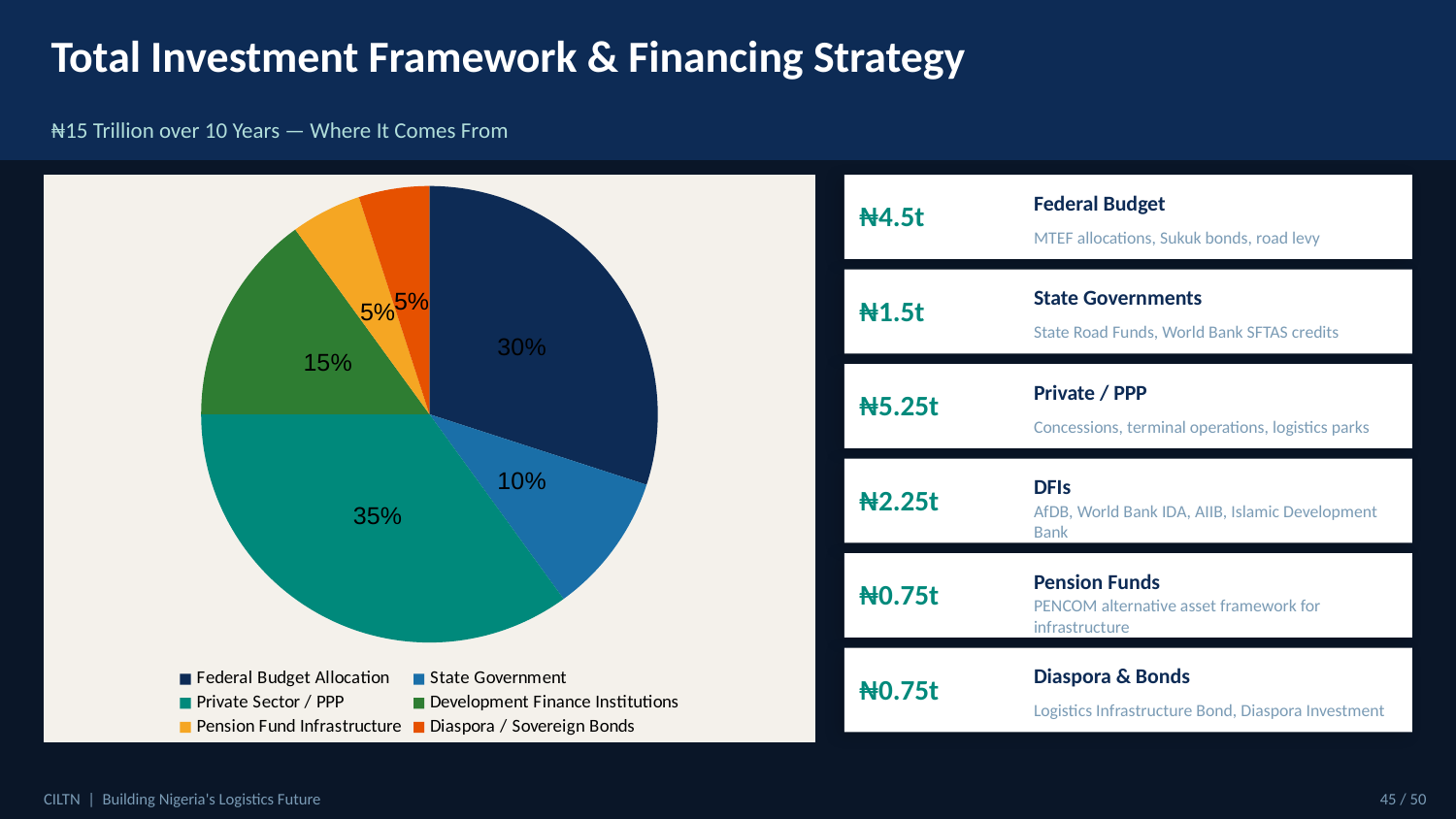
What is the value shown for Federal Budget Allocation? 30% Which is larger, the Federal Budget Allocation slice or the Development Finance Institutions slice? Federal Budget Allocation What colour is the Private Sector / PPP slice in the pie chart? teal How many entries does the legend list? 6 What share of the pie does Private Sector / PPP represent? 35% What is the value shown for State Government? 10% What is the difference between the Development Finance Institutions share and the State Government share? 5% What is the value shown for Development Finance Institutions? 15% Which category has the largest slice of the pie? Private Sector / PPP What type of chart is shown on the slide? pie chart How many slices does the pie chart have? 6 What is the difference between the Private Sector / PPP share and the Federal Budget Allocation share? 5%